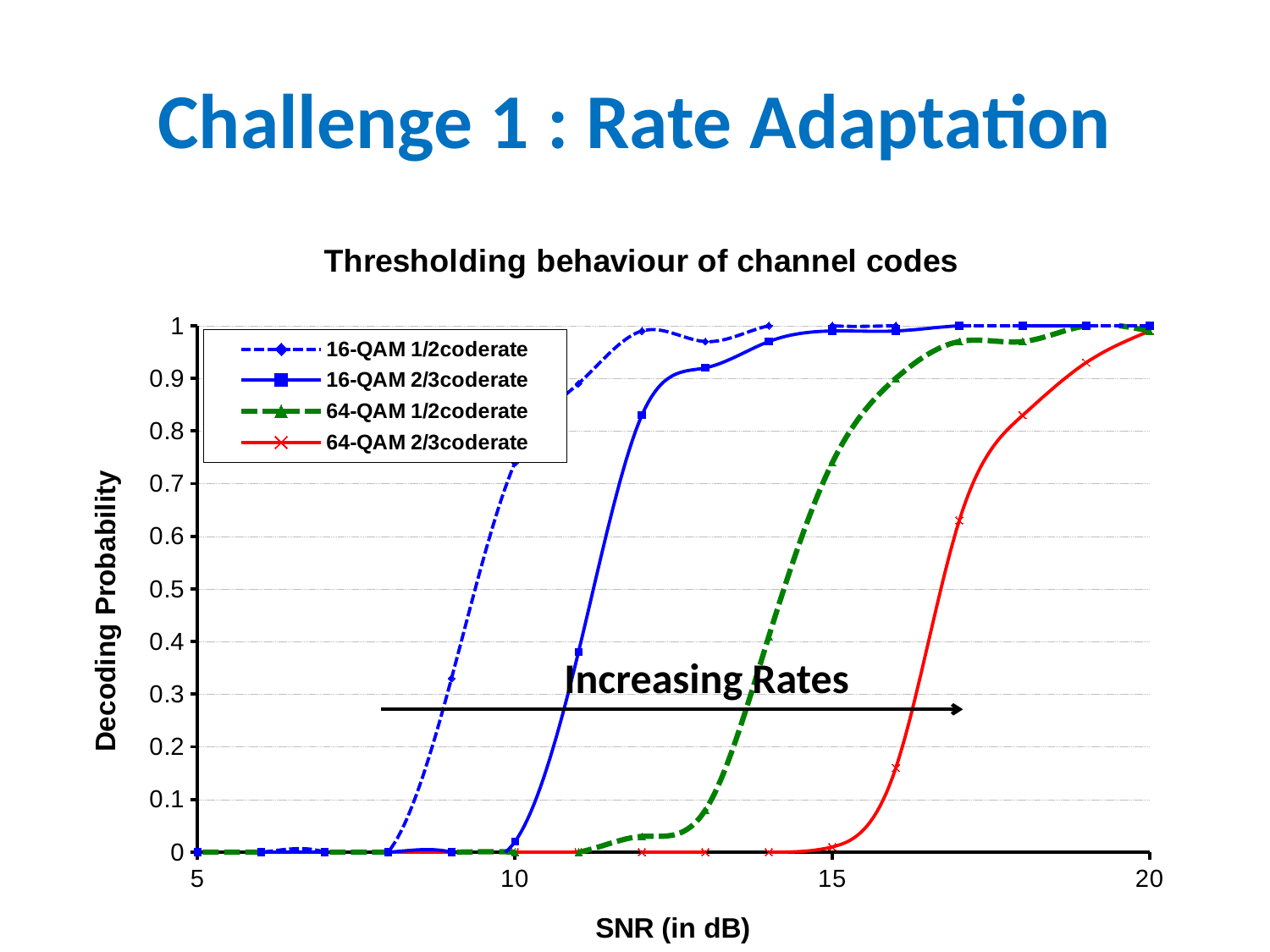
Is the decoding probability for 64-QAM 1/2coderate at an SNR of 15 dB greater or less than 0.5? greater Which series has the highest decoding probability at an SNR of 11 dB? 16-QAM 1/2coderate What is the label of the x axis? SNR (in dB) Is the decoding probability for 16-QAM 1/2coderate at an SNR of 9 dB greater or less than 0.5? less What is the title of the chart? Thresholding behaviour of channel codes Is the decoding probability for 16-QAM 2/3coderate at an SNR of 12 dB greater or less than 0.5? greater At an SNR of 13 dB, which has the higher decoding probability: 16-QAM 2/3coderate or 64-QAM 1/2coderate? 16-QAM 2/3coderate Does the decoding probability for 64-QAM 2/3coderate rise or fall as SNR increases from 15 dB to 20 dB? rise How many series does the legend list? 4 What kind of chart is shown on the slide? line chart Which series has the lowest decoding probability at an SNR of 17 dB? 64-QAM 2/3coderate